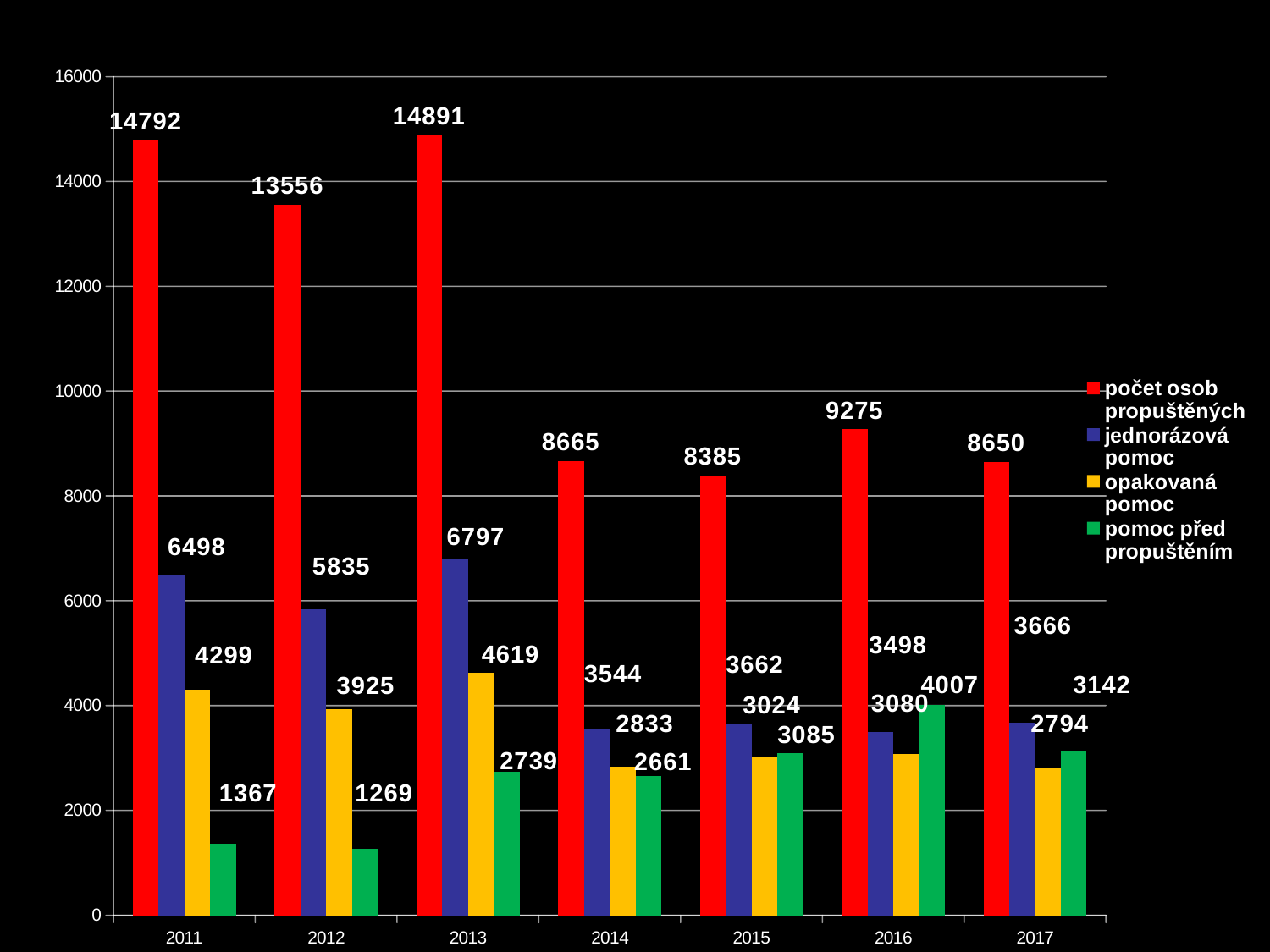
What is the value of opakovaná pomoc in 2015? 3024 What is the difference between počet osob propuštěných in 2013 and in 2011? 99 How many series does the legend list? 4 What is the value of jednorázová pomoc in 2013? 6797 How many years are shown on the x axis? 7 What is the value of pomoc před propuštěním in 2016? 4007 What is the difference between jednorázová pomoc and opakovaná pomoc in 2017? 872 In which year is pomoc před propuštěním lowest? 2012 In which year is počet osob propuštěných highest? 2013 What kind of chart is this? bar chart In 2016, which is larger: jednorázová pomoc or pomoc před propuštěním? pomoc před propuštěním What is the value of počet osob propuštěných in 2011? 14792